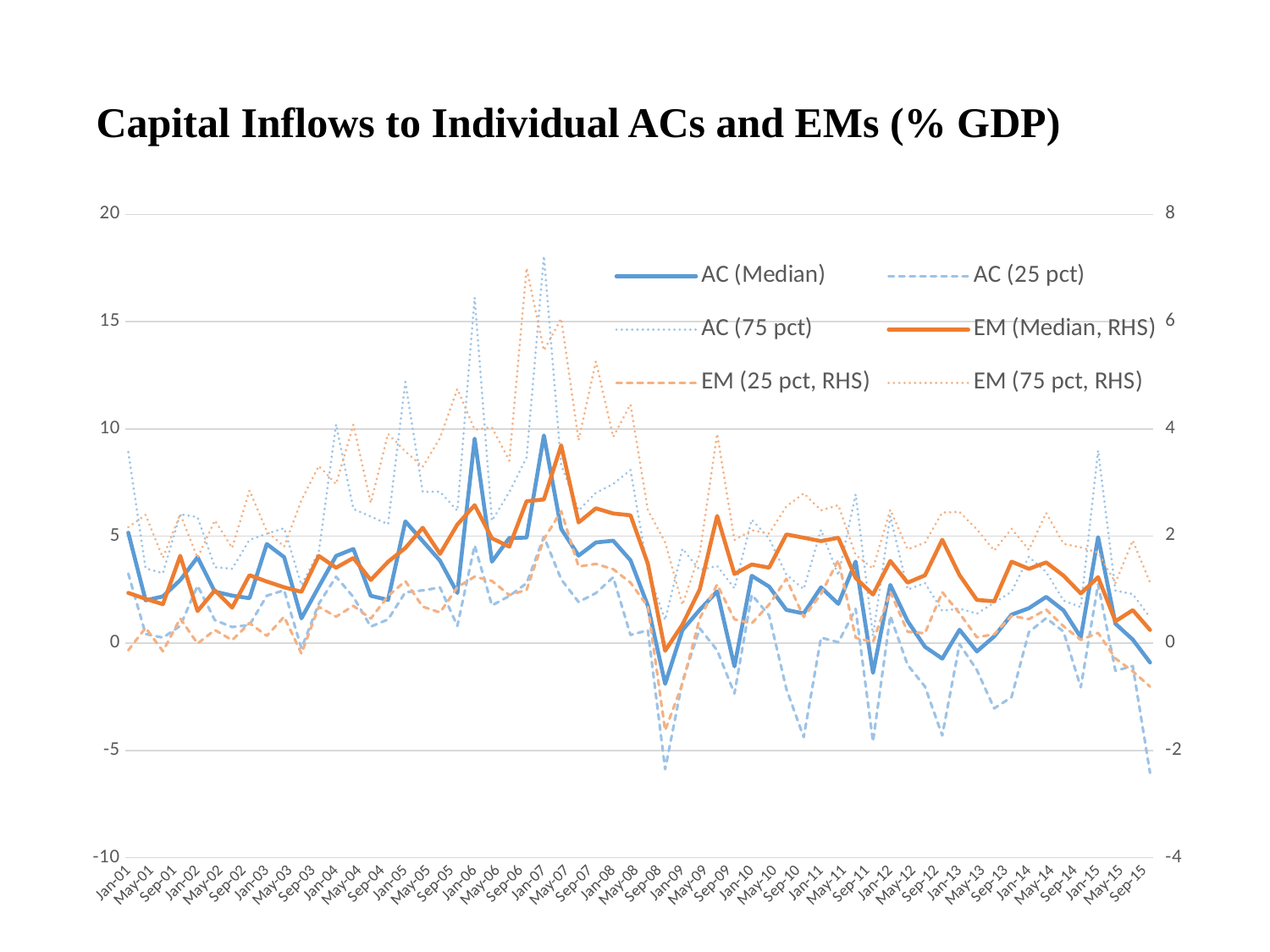
What kind of chart is shown on the slide? Line chart Which is larger for AC (Median): the value at Jan-07 or the value at Sep-08? Jan-07 Is the value of AC (Median) at Sep-08 greater or less than 0? less Is the value of AC (25 pct) at Sep-15 greater or less than -5? less Does AC (Median) rise or fall between Jan-07 and Sep-08? Fall Is the value of AC (Median) at Jan-07 greater or less than 5? greater Which axis, left or right, is used for the EM (Median, RHS) series? Right How many series does the legend list? 6 Does EM (Median, RHS) rise or fall between Jan-15 and Sep-15? Fall What is the title of the chart? Capital Inflows to Individual ACs and EMs (% GDP)